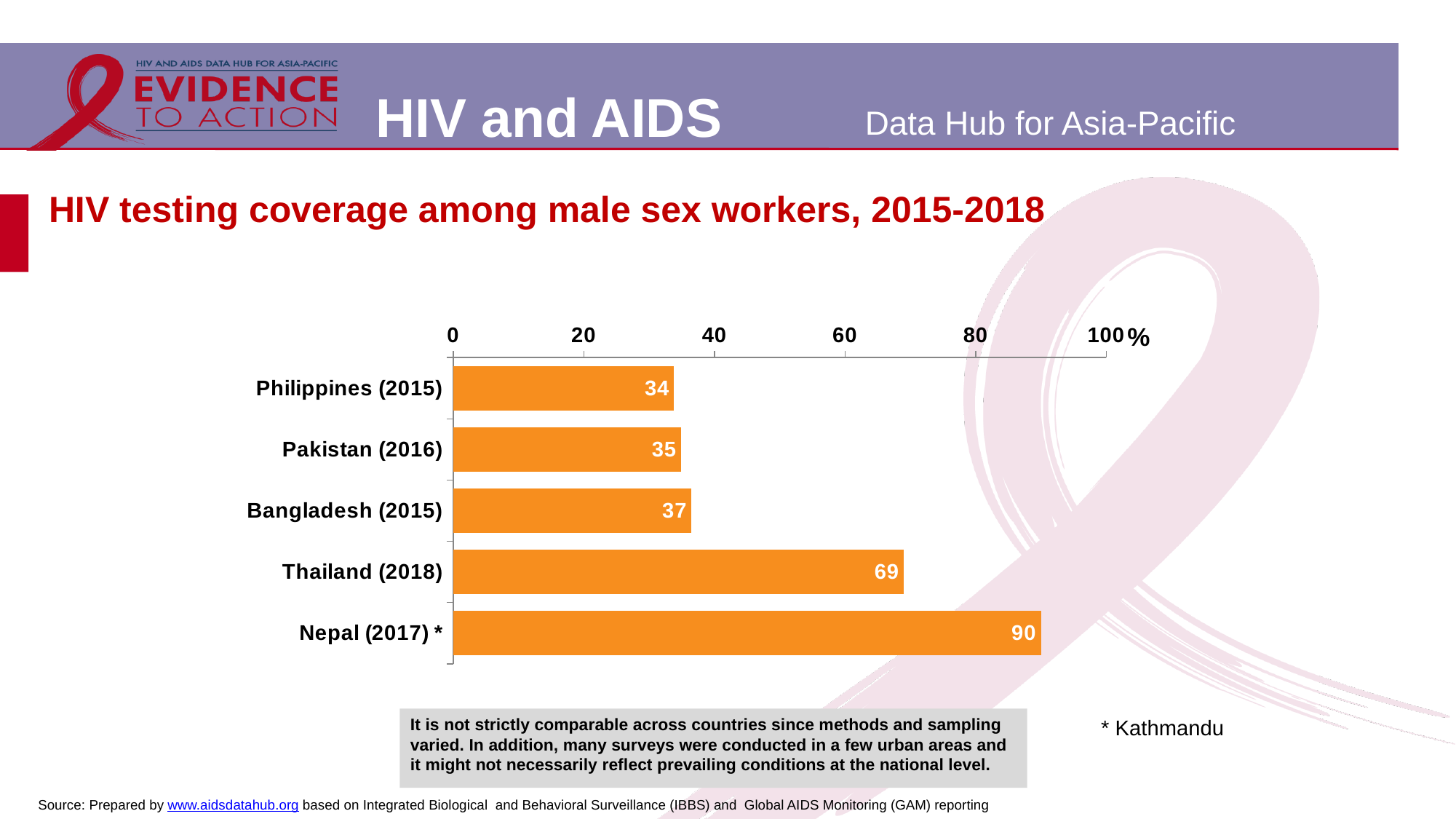
Is the value for Pakistan (2016) greater or less than 40? less What is the HIV testing coverage value for Thailand (2018)? 69 What does the asterisk next to Nepal (2017) refer to? Kathmandu How many countries are shown in the chart? 5 What is the difference between the values for Bangladesh (2015) and Pakistan (2016)? 2 What is the HIV testing coverage value for Philippines (2015)? 34 Which has a larger value, Thailand (2018) or Bangladesh (2015)? Thailand (2018) What kind of chart is shown on the slide? bar chart What is the difference between the values for Nepal (2017) * and Thailand (2018)? 21 What is the value shown for Bangladesh (2015)? 37 Which country has the lowest HIV testing coverage among male sex workers? Philippines (2015) Which country has the highest HIV testing coverage among male sex workers? Nepal (2017) *